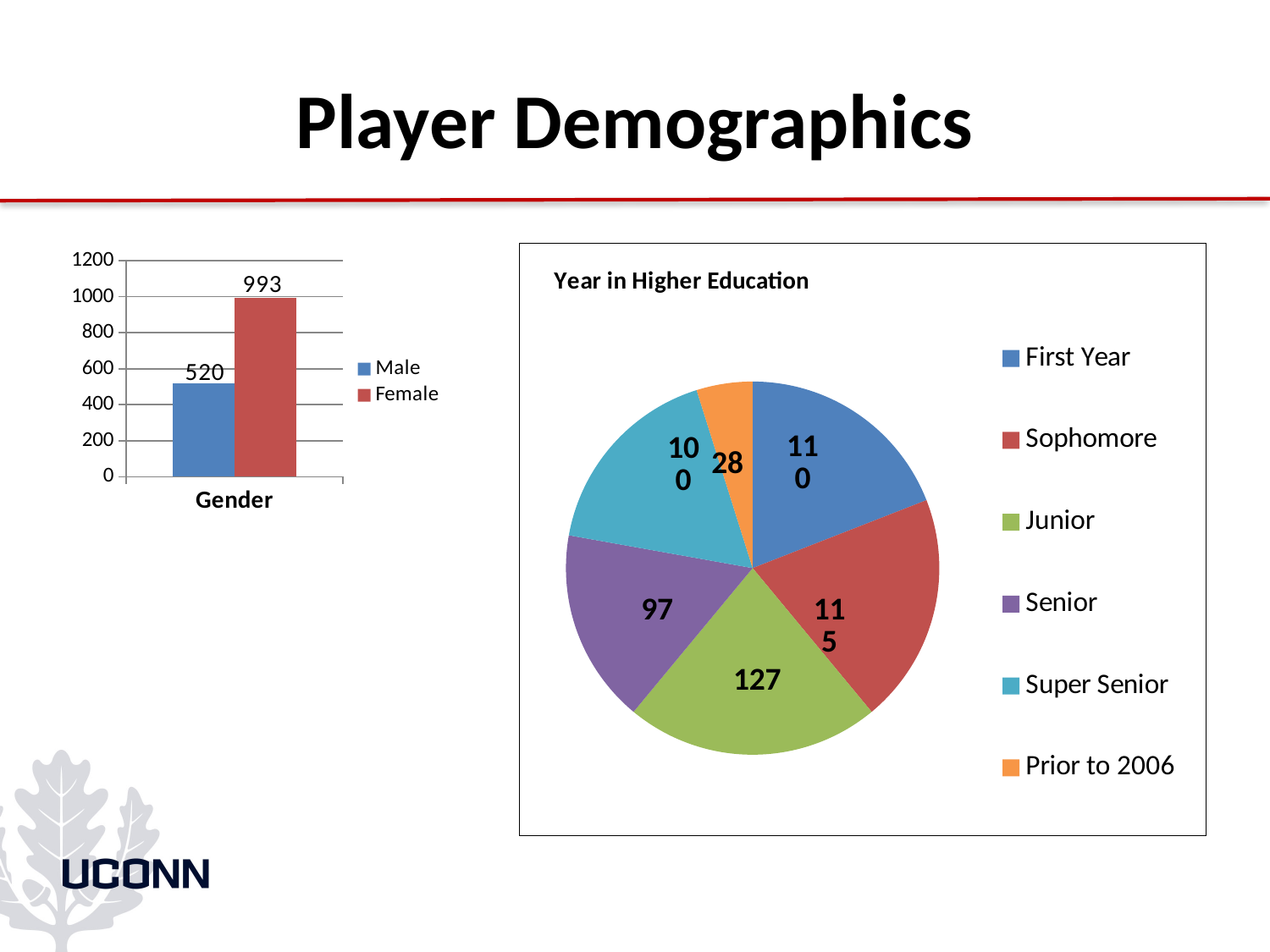
On the Year in Higher Education pie chart, what is the value for Prior to 2006? 28 On the Gender bar chart, which is larger, Male or Female? Female On the Year in Higher Education pie chart, which category has the largest value? Junior How many categories does the Year in Higher Education pie chart show? 6 On the Gender bar chart, what is the value for Male? 520 On the Year in Higher Education pie chart, which category has the smallest value? Prior to 2006 How many series does the legend of the Gender bar chart list? 2 What kind of chart is the Gender chart on the left? Bar chart On the Gender bar chart, what is the value for Female? 993 On the Year in Higher Education pie chart, what is the difference between the Junior and Senior values? 30 On the Gender bar chart, what is the difference between the Female and Male values? 473 On the Year in Higher Education pie chart, what is the value for Junior? 127